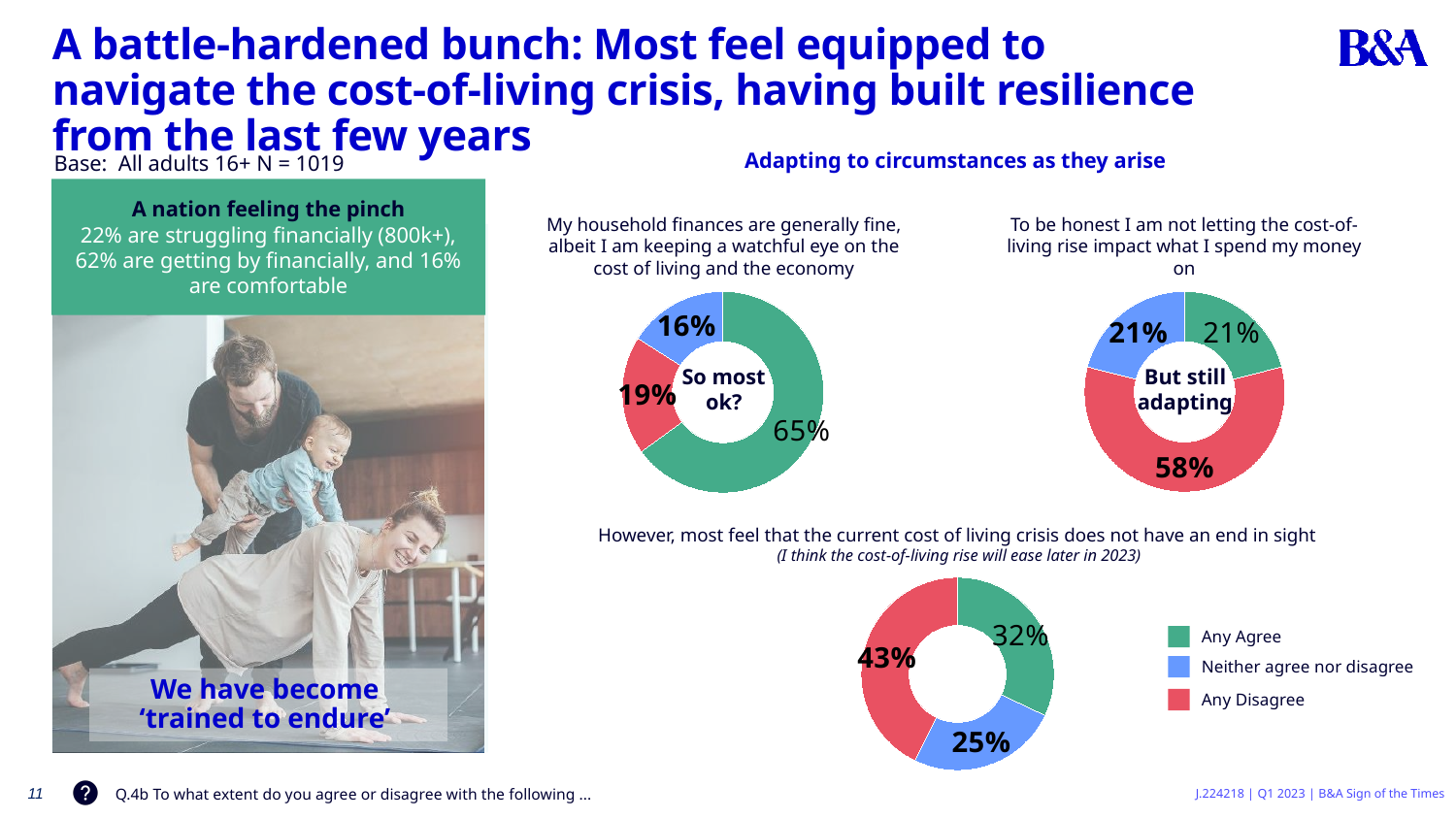
In the chart for 'To be honest I am not letting the cost-of-living rise impact what I spend my money on', what percentage are Any Disagree? 58% In the chart for 'I think the cost-of-living rise will ease later in 2023', what is the difference between the Any Disagree and Any Agree shares? 11 percentage points In the chart for 'I think the cost-of-living rise will ease later in 2023', which category has the smallest share? Neither agree nor disagree In the chart for 'My household finances are generally fine...', what percentage are Neither agree nor disagree? 16% In the chart for 'I think the cost-of-living rise will ease later in 2023', what percentage are Neither agree nor disagree? 25% In the chart for 'To be honest I am not letting the cost-of-living rise impact what I spend my money on', which category has the largest share? Any Disagree In the chart for 'I think the cost-of-living rise will ease later in 2023', what percentage are Any Agree? 32% In the chart for 'My household finances are generally fine, albeit I am keeping a watchful eye on the cost of living and the economy', what share of respondents are in the Any Agree category? 65% How many categories does the legend on the slide list? 3 In the chart for 'My household finances are generally fine...', what percentage are Any Disagree? 19% What type of chart is used to show the responses on this slide? Donut (pie) chart In the chart for 'My household finances are generally fine...', which is larger: Any Disagree or Neither agree nor disagree? Any Disagree